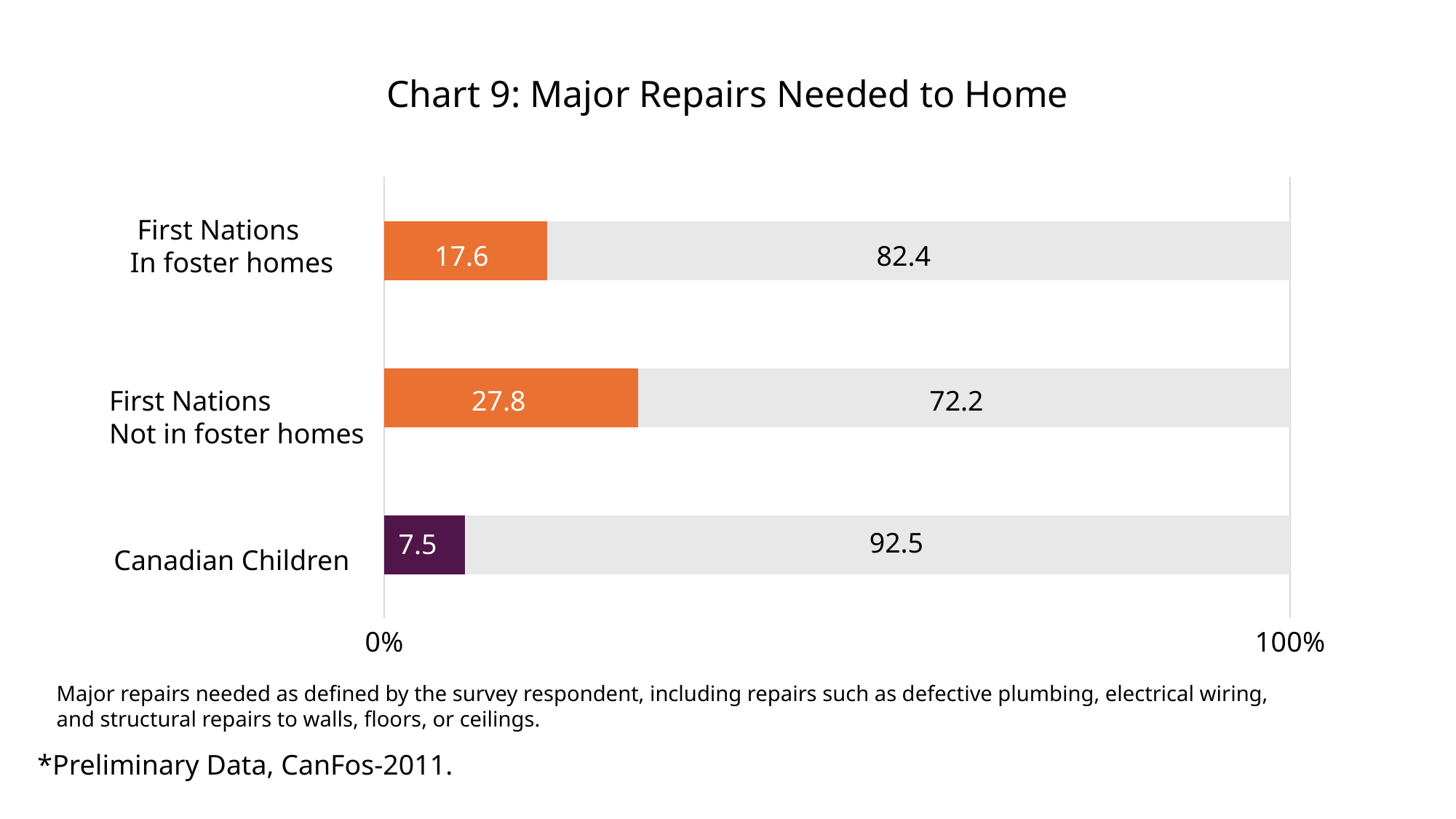
What is the title of the chart? Chart 9: Major Repairs Needed to Home Which is larger: the coloured segment for First Nations In foster homes or for Canadian Children? First Nations In foster homes What is the difference between the coloured segment values for First Nations Not in foster homes and First Nations In foster homes? 10.2 What is the value of the coloured (left) segment for Canadian Children? 7.5 What is the value of the grey segment for First Nations In foster homes? 82.4 What is the value of the grey segment for First Nations Not in foster homes? 72.2 What kind of chart is this? Stacked bar chart How many categories are shown on the chart? 3 What is the value of the coloured (left) segment for First Nations In foster homes? 17.6 Which category has the largest coloured (left) segment? First Nations Not in foster homes Which category has the smallest coloured (left) segment? Canadian Children What is the total of the stacked bar for Canadian Children? 100